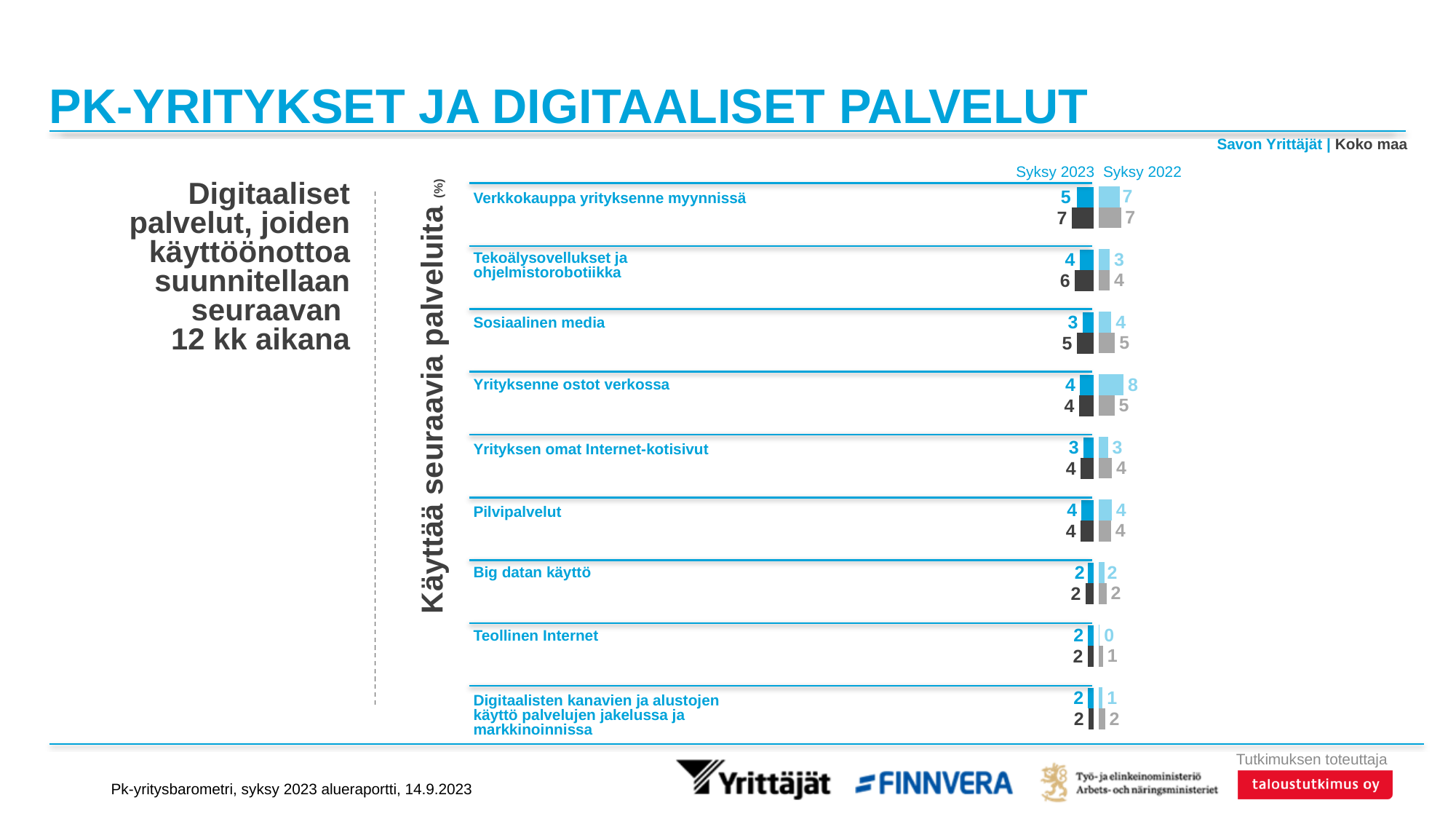
What is the difference between the Savon Yrittäjät Syksy 2022 and Syksy 2023 values for Yrityksenne ostot verkossa? 4 What is the Savon Yrittäjät Syksy 2023 value for Verkkokauppa yrityksenne myynnissä? 5 How many digital service categories are listed in the chart? 9 How many time periods does the chart legend list? 2 What is the unit shown on the chart's axis label? % Which category has the lowest Savon Yrittäjät Syksy 2022 value? Teollinen Internet What is the Savon Yrittäjät Syksy 2022 value for Yrityksenne ostot verkossa? 8 For Verkkokauppa yrityksenne myynnissä, which is larger: the Savon Yrittäjät Syksy 2023 value or the Koko maa Syksy 2023 value? Koko maa Syksy 2023 What is the Koko maa Syksy 2022 value for Sosiaalinen media? 5 Which category has the highest Savon Yrittäjät Syksy 2023 value? Verkkokauppa yrityksenne myynnissä What kind of chart is shown on the slide? Bar chart What is the Koko maa Syksy 2023 value for Tekoälysovellukset ja ohjelmistorobotiikka? 6